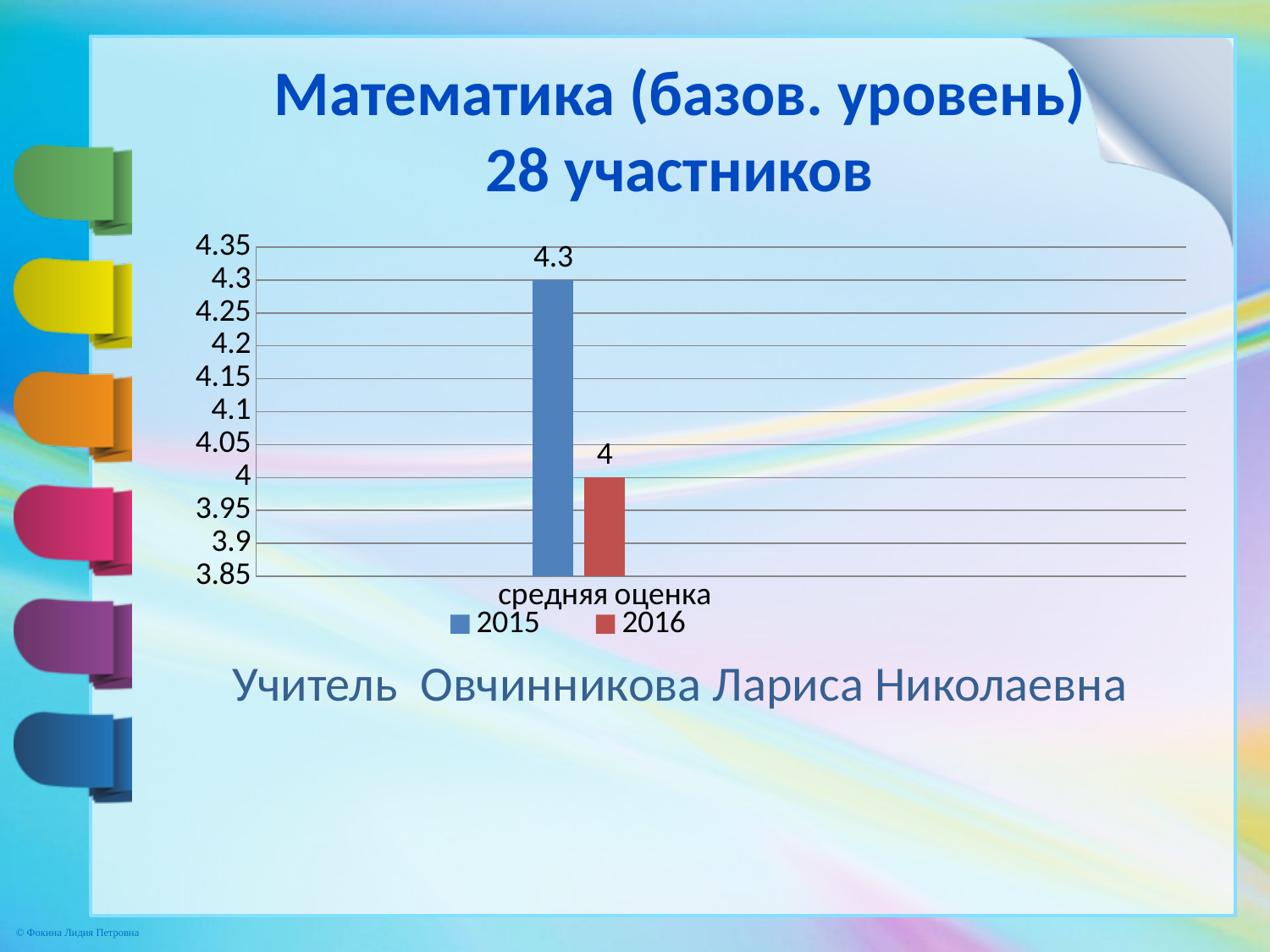
What is the value for 2016 in the средняя оценка category? 4 How many series does the legend list? 2 What is the label of the category on the x axis? средняя оценка Which series has the lowest value in the chart? 2016 Which series has the higher value for средняя оценка, 2015 or 2016? 2015 Is the value for 2015 greater or less than 4.2? greater What kind of chart is shown on the slide? bar chart Which series is shown in red in the legend? 2016 What is the difference between the 2015 and 2016 values for средняя оценка? 0.3 Is the value for 2016 greater or less than 4.1? less How many categories are shown on the x axis? 1 What is the value for 2015 in the средняя оценка category? 4.3